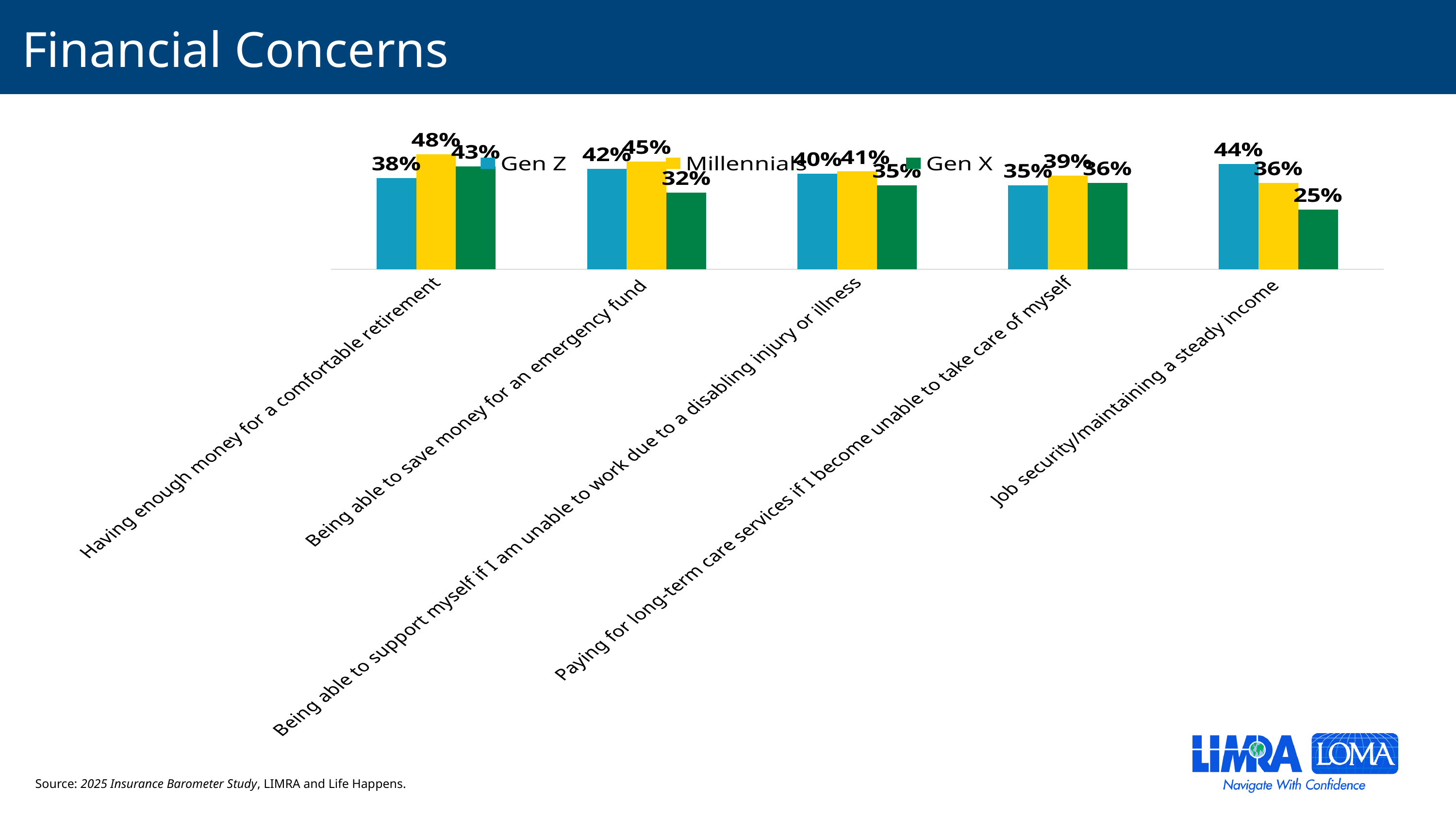
What is the Gen Z value for 'Job security/maintaining a steady income'? 44% What is the difference between the Gen Z and Gen X values for 'Job security/maintaining a steady income'? 19% For 'Being able to save money for an emergency fund', which is larger: the Gen Z value or the Gen X value? Gen Z How many series does the legend list? 3 What kind of chart is shown on the slide? bar chart Which series is shown in yellow in the legend? Millennials What is the Millennials value for 'Paying for long-term care services if I become unable to take care of myself'? 39% What is the Gen X value for 'Being able to save money for an emergency fund'? 32% Which category has the lowest Gen X value? Job security/maintaining a steady income Which category has the highest Gen Z value? Job security/maintaining a steady income What is the Millennials value for 'Having enough money for a comfortable retirement'? 48% How many categories are shown on the x axis? 5